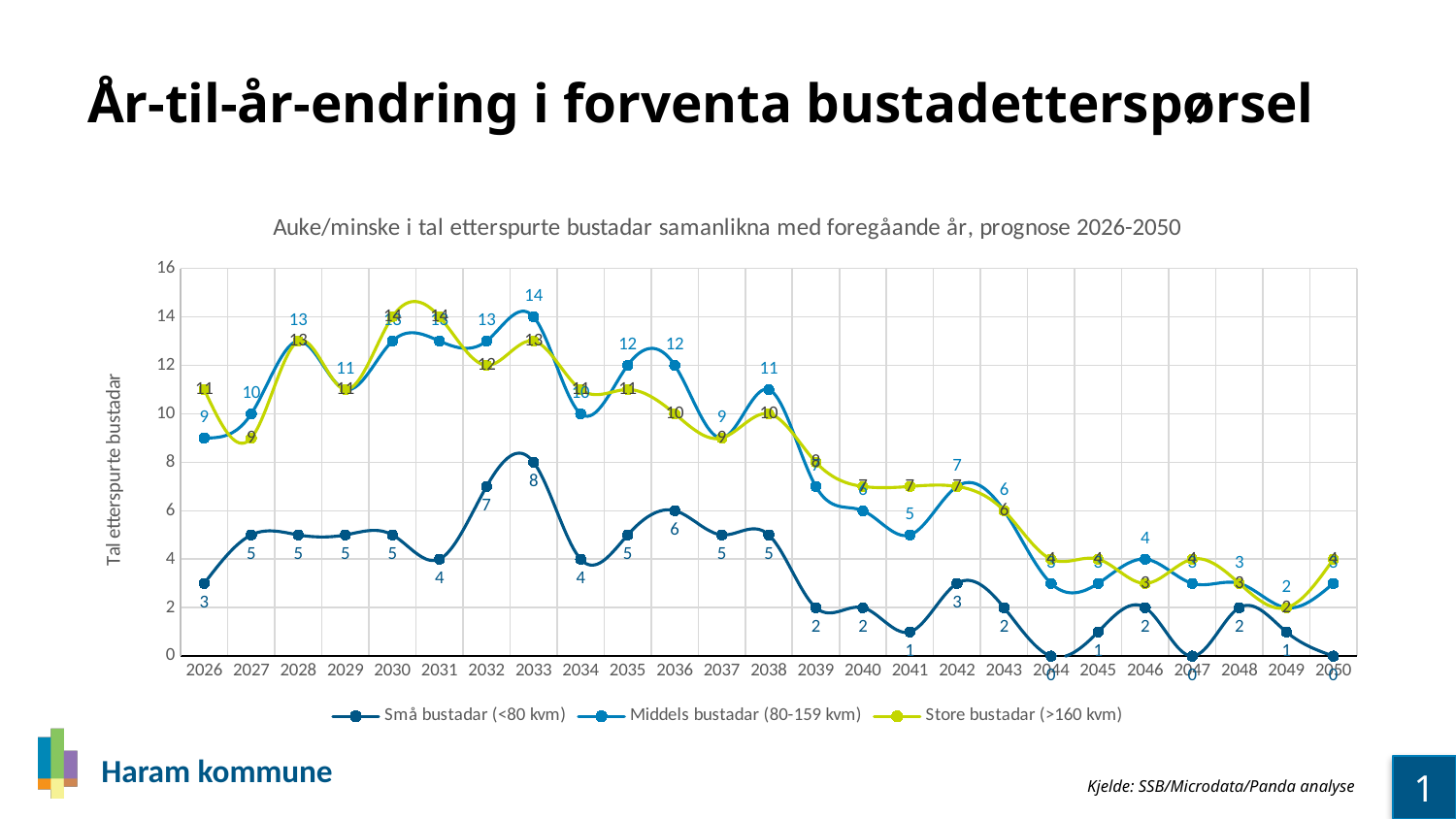
In which year does Små bustadar (<80 kvm) reach its highest value? 2033 What is the difference between Middels bustadar (80-159 kvm) and Små bustadar (<80 kvm) in 2033? 6 Does the Store bustadar (>160 kvm) series generally rise or fall from 2033 to 2049? fall What kind of chart is shown on the slide? line chart What is the value for Middels bustadar (80-159 kvm) in 2033? 14 In which year does Middels bustadar (80-159 kvm) reach its highest value? 2033 What is the value for Store bustadar (>160 kvm) in 2039? 8 How many years are plotted along the x axis? 25 What is the value for Middels bustadar (80-159 kvm) in 2041? 5 How many series does the legend list? 3 In 2041, which is larger: Middels bustadar (80-159 kvm) or Store bustadar (>160 kvm)? Store bustadar (>160 kvm) What is the value for Små bustadar (<80 kvm) in 2033? 8